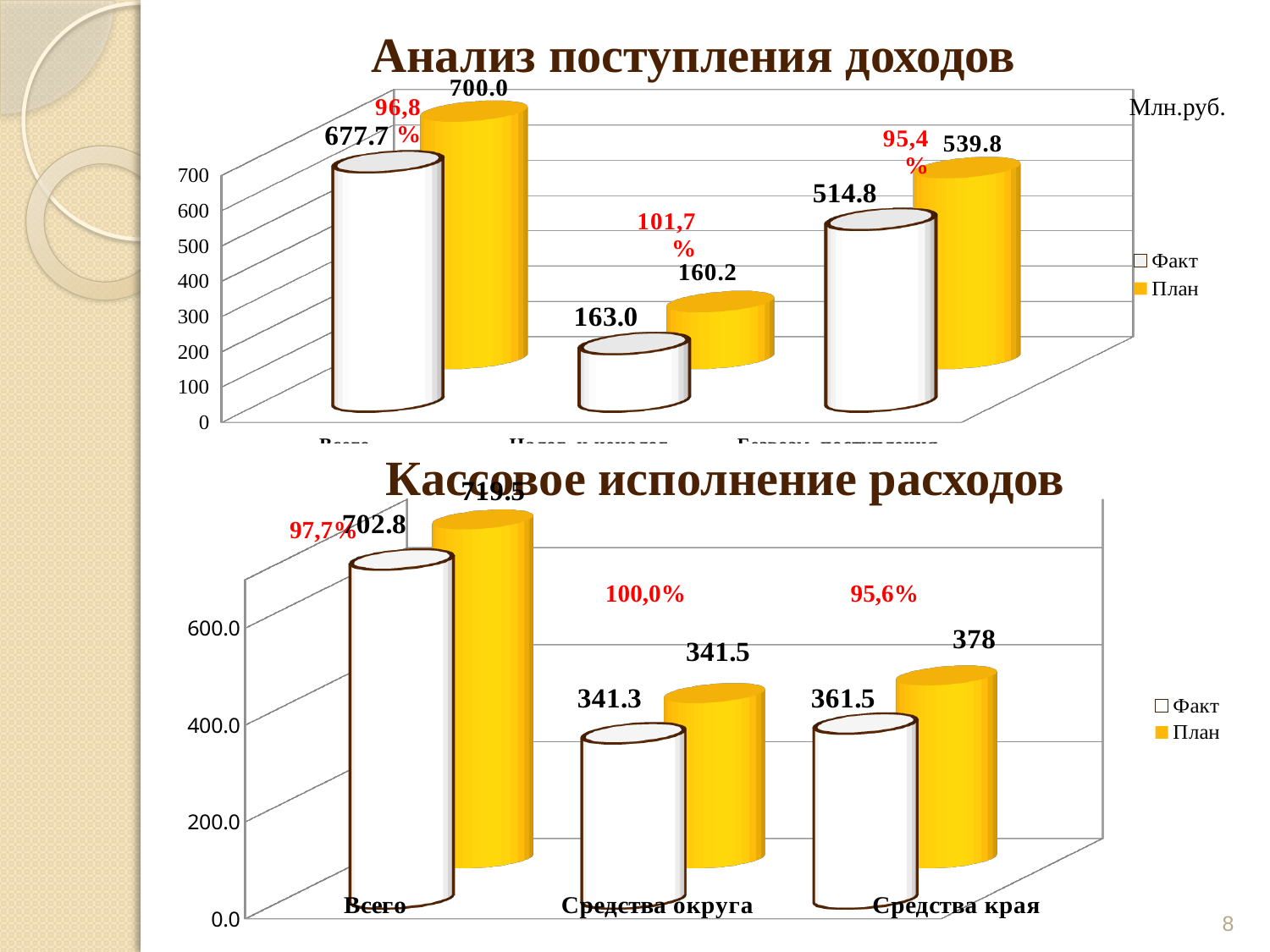
On the chart titled "Кассовое исполнение расходов", how many categories are shown on the x axis? 3 On the chart titled "Кассовое исполнение расходов", what is the difference between the План and Факт values for Средства края? 16.5 On the chart titled "Кассовое исполнение расходов", what is the Факт value for Всего? 702.8 On the chart titled "Анализ поступления доходов", what is the difference between the План and Факт values for the leftmost group of bars? 22.3 On the chart titled "Анализ поступления доходов", what is the Факт value for the middle group of bars? 163.0 On the chart titled "Кассовое исполнение расходов", which category has the lowest Факт value? Средства округа What type of chart is the chart titled "Анализ поступления доходов"? Bar chart On the chart titled "Анализ поступления доходов", what is the План value for the first (leftmost) group of bars? 700.0 On the chart titled "Анализ поступления доходов", which is larger for the rightmost group of bars, Факт or План? План On the chart titled "Кассовое исполнение расходов", how many series does the legend list? 2 On the chart titled "Кассовое исполнение расходов", what is the План value for Средства края? 378 On the chart titled "Кассовое исполнение расходов", what is the Факт value for Средства округа? 341.3